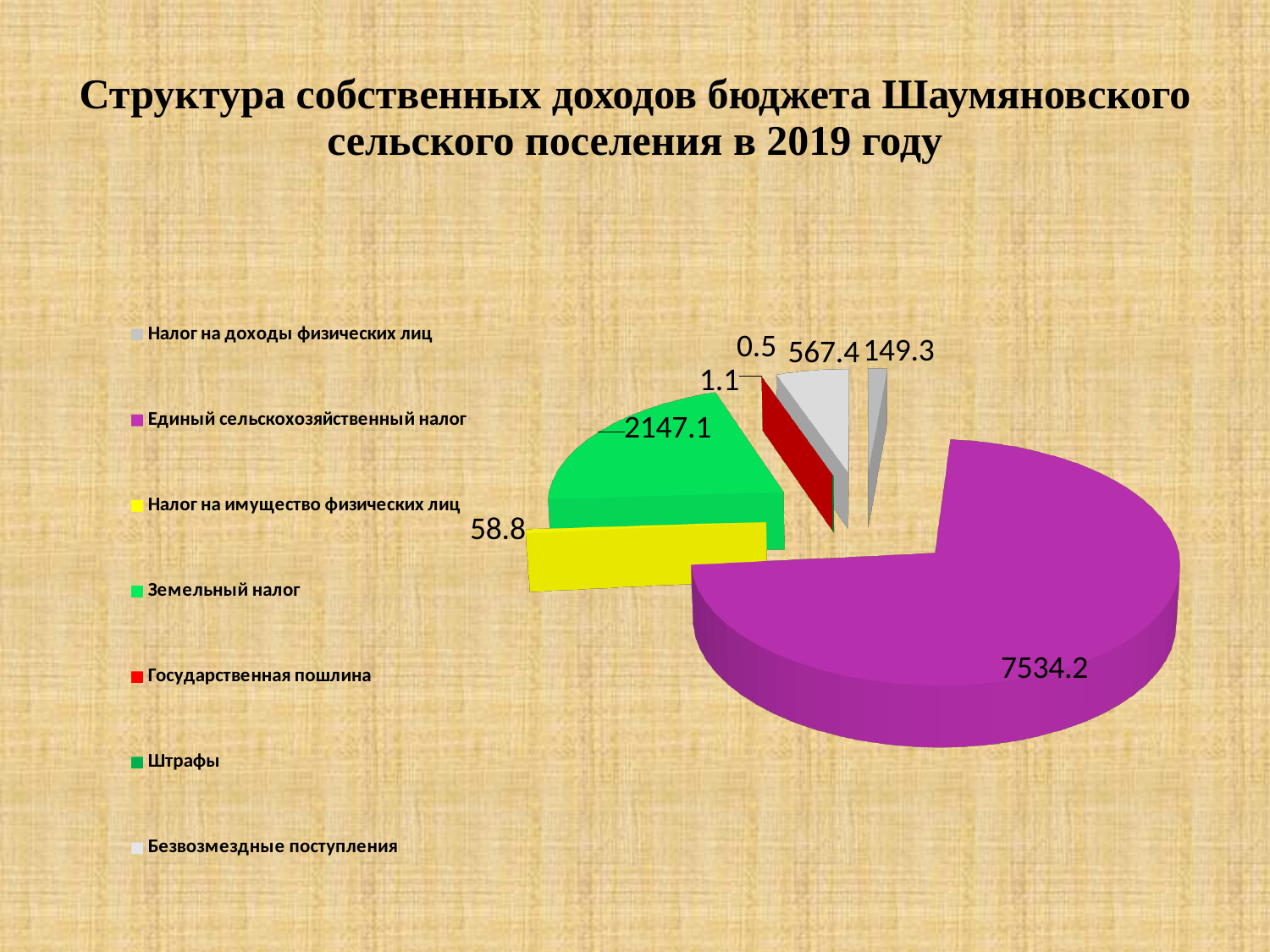
What is the value for Налог на имущество физических лиц? 58.8 What is the value for Земельный налог? 2147.1 What is the smallest value labelled on the pie chart? 0.5 What is the value for Единый сельскохозяйственный налог? 7534.2 What colour is the slice for Земельный налог? green What kind of chart is shown on the slide? pie chart Which is larger, Земельный налог or Налог на имущество физических лиц? Земельный налог What is the difference between Единый сельскохозяйственный налог and Земельный налог? 5387.1 Which category has the largest slice of the pie? Единый сельскохозяйственный налог How many categories does the legend list? 7 What is the difference between Земельный налог and Налог на имущество физических лиц? 2088.3 What is the value for Налог на доходы физических лиц? 149.3